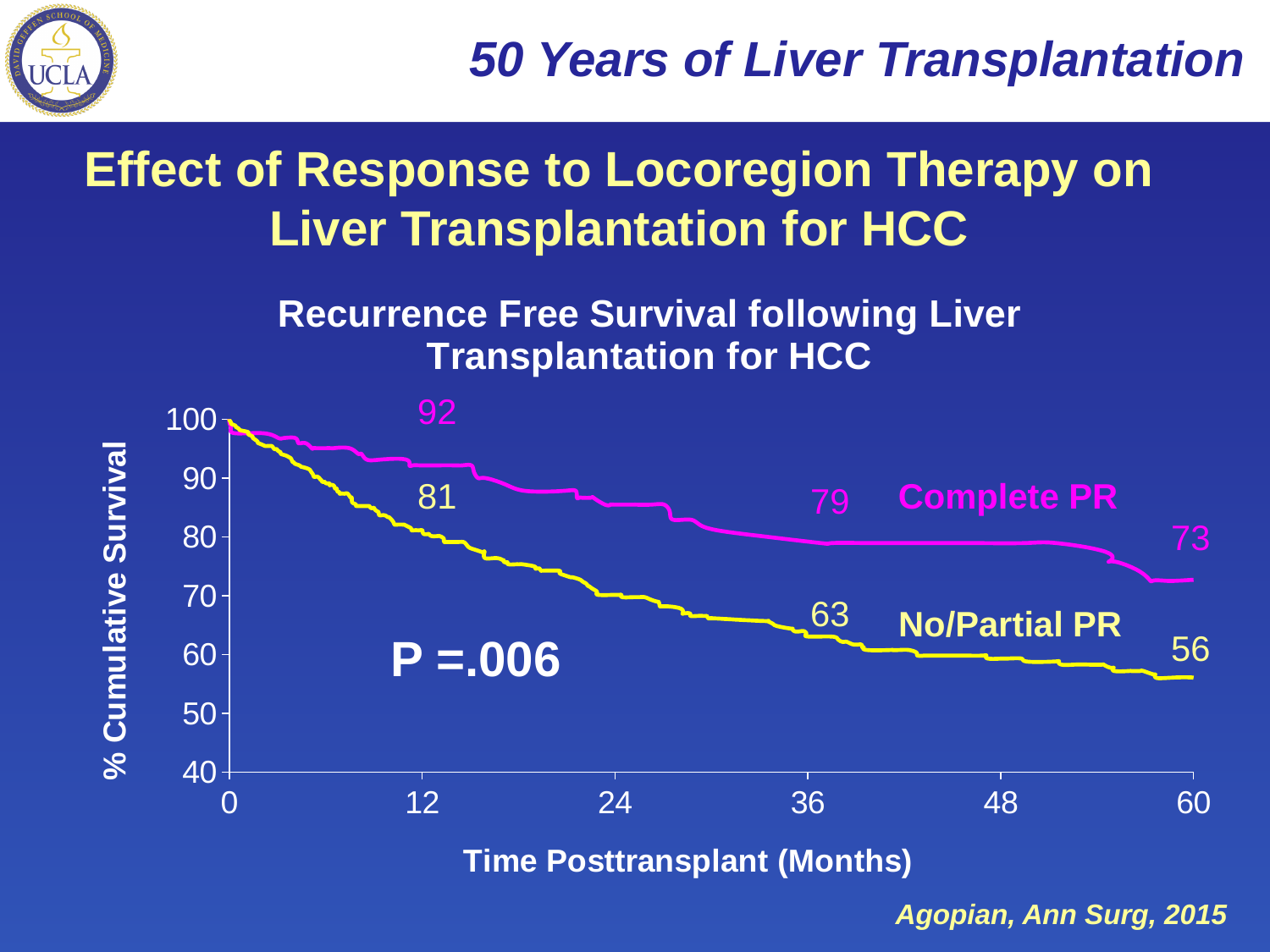
Which group has the higher cumulative survival at 36 months, Complete PR or No/Partial PR? Complete PR What is the labelled % cumulative survival for the No/Partial PR group at 60 months? 56 What P value is shown on the chart? P =.006 Do the survival curves rise or fall as time posttransplant increases? Fall What is the labelled % cumulative survival for the No/Partial PR group at 36 months? 63 Is the value for the Complete PR group at 24 months greater or less than 80? greater How many groups (series) are plotted on the chart? 2 What is the labelled % cumulative survival for the Complete PR group at 12 months? 92 What is the difference between the labelled survival values of the Complete PR and No/Partial PR groups at 12 months? 11 What kind of chart is shown on the slide? Line chart What is the labelled % cumulative survival for the Complete PR group at 60 months? 73 What is the difference between the labelled survival values of the Complete PR and No/Partial PR groups at 60 months? 17